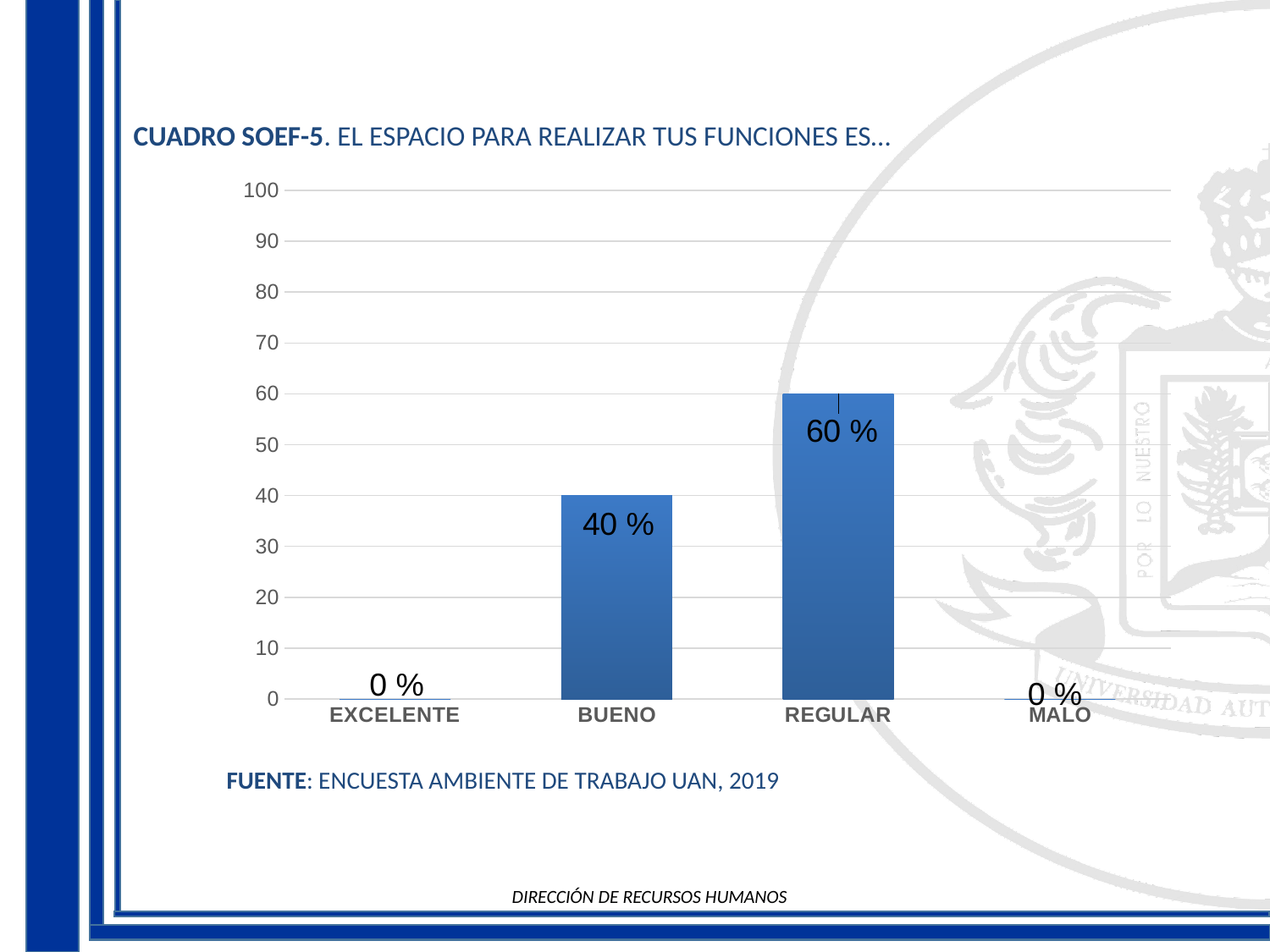
What kind of chart is shown on the slide? bar chart What is the title of the chart? CUADRO SOEF-5. EL ESPACIO PARA REALIZAR TUS FUNCIONES ES... What is the value for MALO? 0 % What is the value for EXCELENTE? 0 % Which is larger, the value for BUENO or the value for REGULAR? REGULAR What is the difference between the values for REGULAR and BUENO? 20 % How many categories are shown on the x axis? 4 Which category has the highest value? REGULAR What is the value for REGULAR? 60 % What is the value for BUENO? 40 % Is the value for REGULAR greater or less than 50? greater What is the source cited below the chart? ENCUESTA AMBIENTE DE TRABAJO UAN, 2019